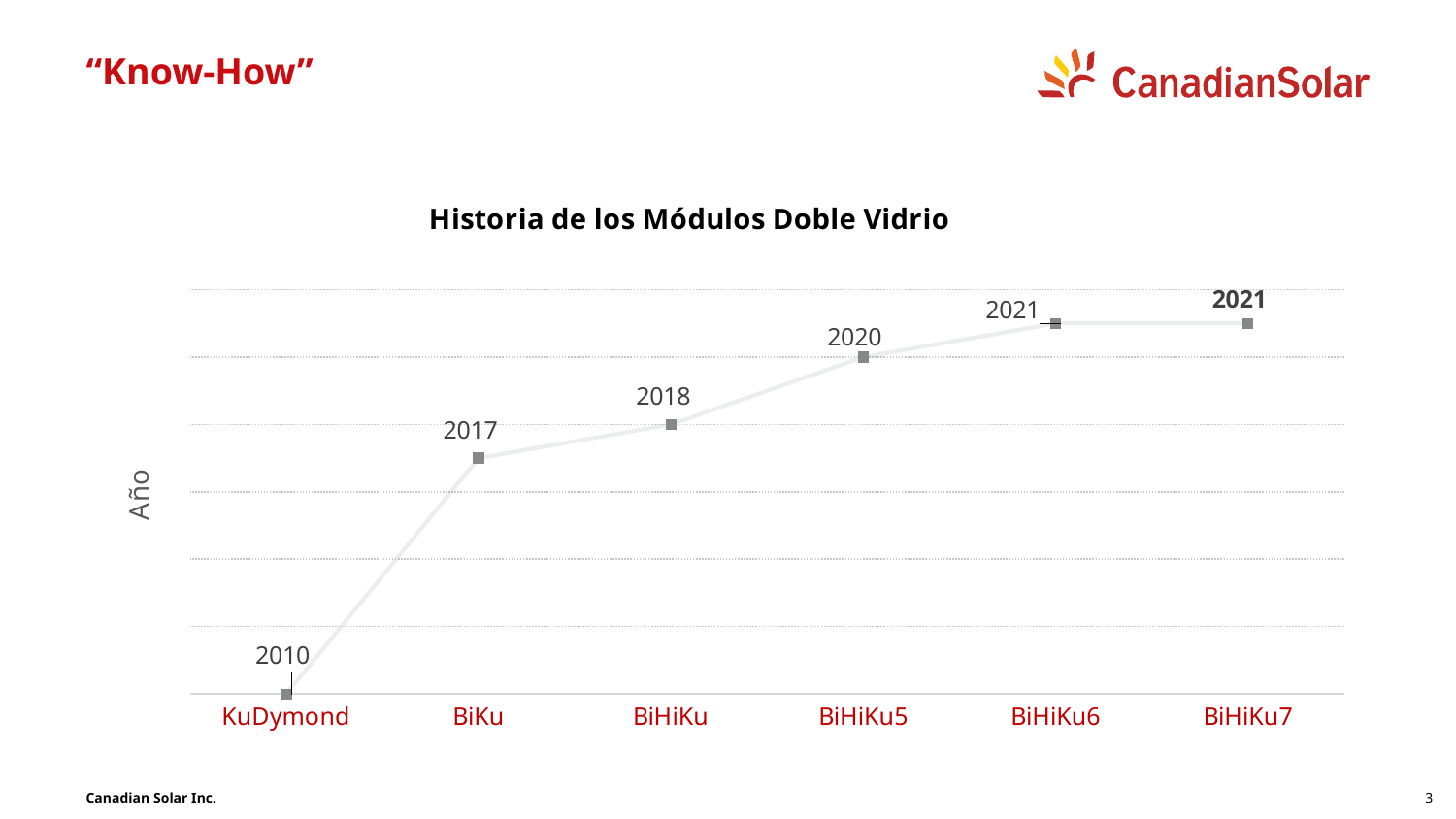
Which module has the later year, BiKu or BiHiKu5? BiHiKu5 What year is shown for the BiKu module? 2017 How many modules are plotted on the chart? 6 What year is shown for the BiHiKu5 module? 2020 How many years separate the BiKu module from the KuDymond module? 7 What kind of chart is shown on the slide? Line chart What year is shown for the BiHiKu module? 2018 What year is shown for the BiHiKu7 module? 2021 How many years separate the BiHiKu5 module from the BiHiKu module? 2 What year is shown for the KuDymond module? 2010 What is the title of the chart? Historia de los Módulos Doble Vidrio Which module has the earliest year on the chart? KuDymond